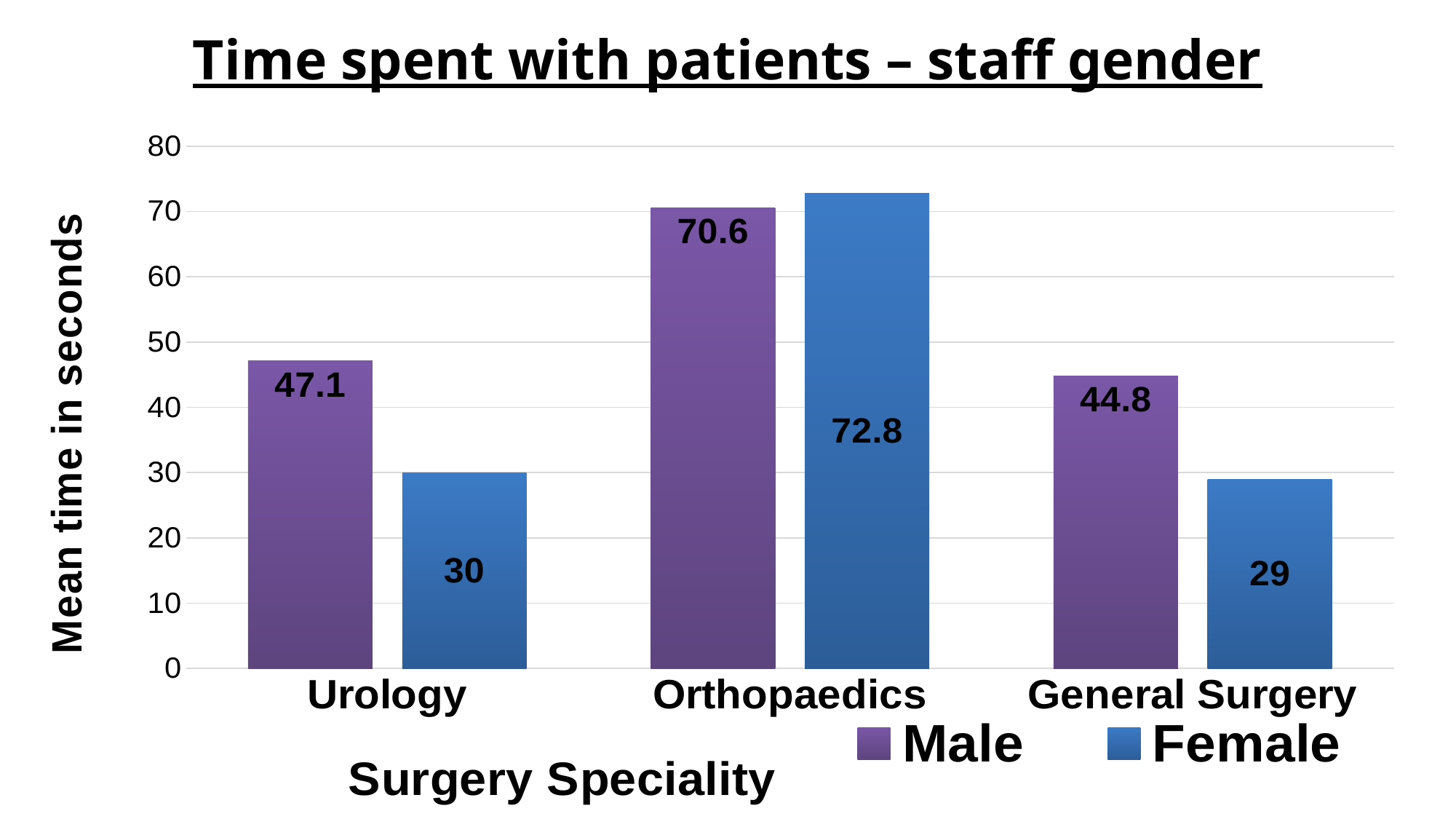
What is the difference between the Female and Male mean times in Orthopaedics? 2.2 What is the difference between the Male and Female mean times in Urology? 17.1 What kind of chart is shown on the slide? Bar chart What is the mean time in seconds for Female staff in Orthopaedics? 72.8 Is the Male mean time in General Surgery greater or less than 40? greater Which is larger in General Surgery, the Male or the Female mean time? Male Which surgery speciality has the highest mean time for Male staff? Orthopaedics How many series does the legend list? 2 How many surgery specialities are shown on the x axis? 3 What is the mean time in seconds for Male staff in Urology? 47.1 What is the mean time in seconds for Female staff in General Surgery? 29 Which surgery speciality has the lowest mean time for Female staff? General Surgery